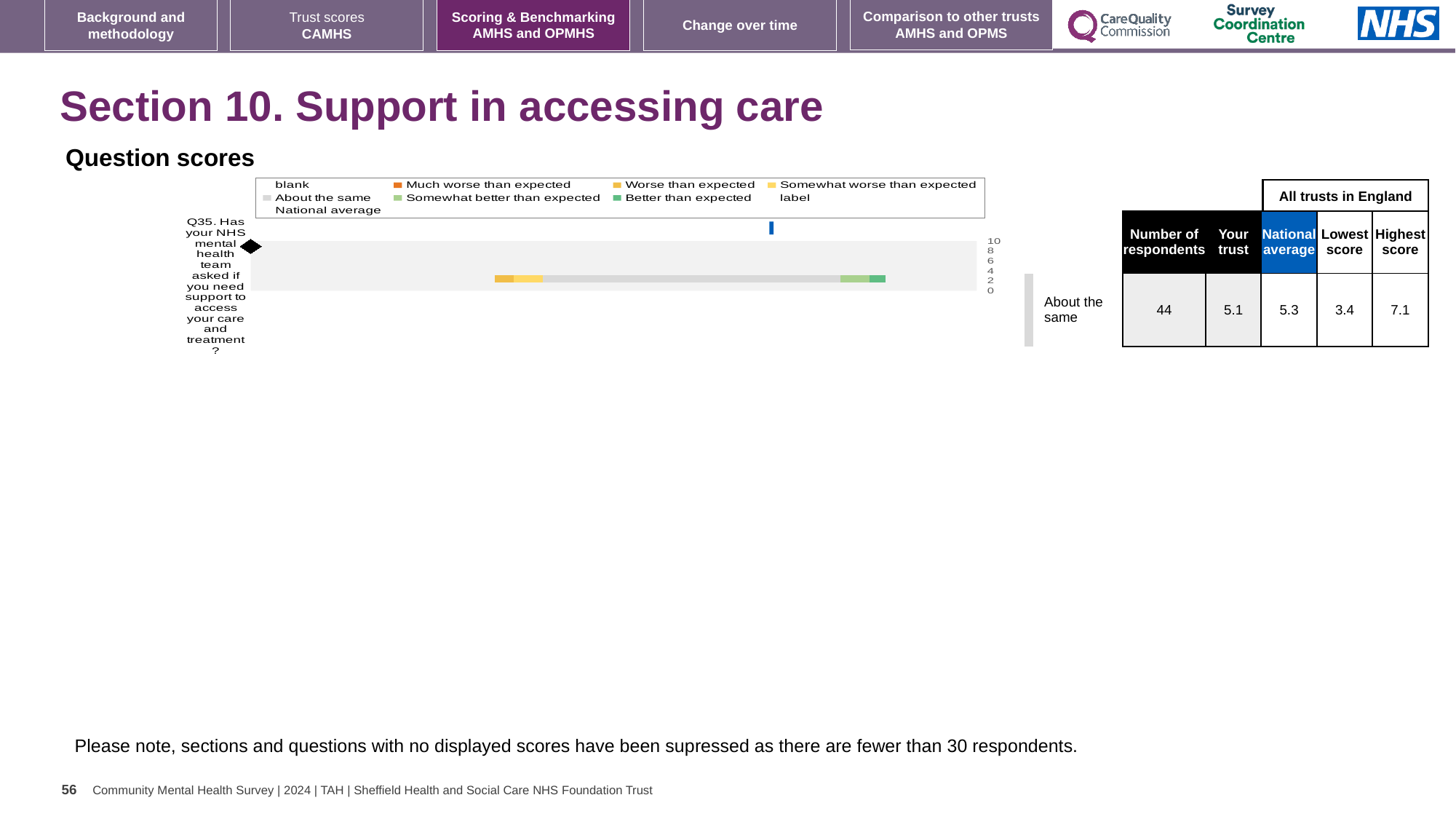
What is the 'Your trust' score for Q35? 5.1 What is the difference between the national average and the trust's score for Q35? 0.2 What kind of chart is used to show the Q35 question score? bar chart What is the benchmark category label shown to the right of the Q35 bar? About the same What is the highest score among all trusts in England for Q35? 7.1 Which is larger for Q35, the trust's score or the national average? National average How many respondents answered Q35? 44 What is the lowest score among all trusts in England for Q35? 3.4 What is the national average score for Q35? 5.3 What is the difference between the highest and lowest trust scores for Q35? 3.7 How many questions are plotted in the Question scores chart? 1